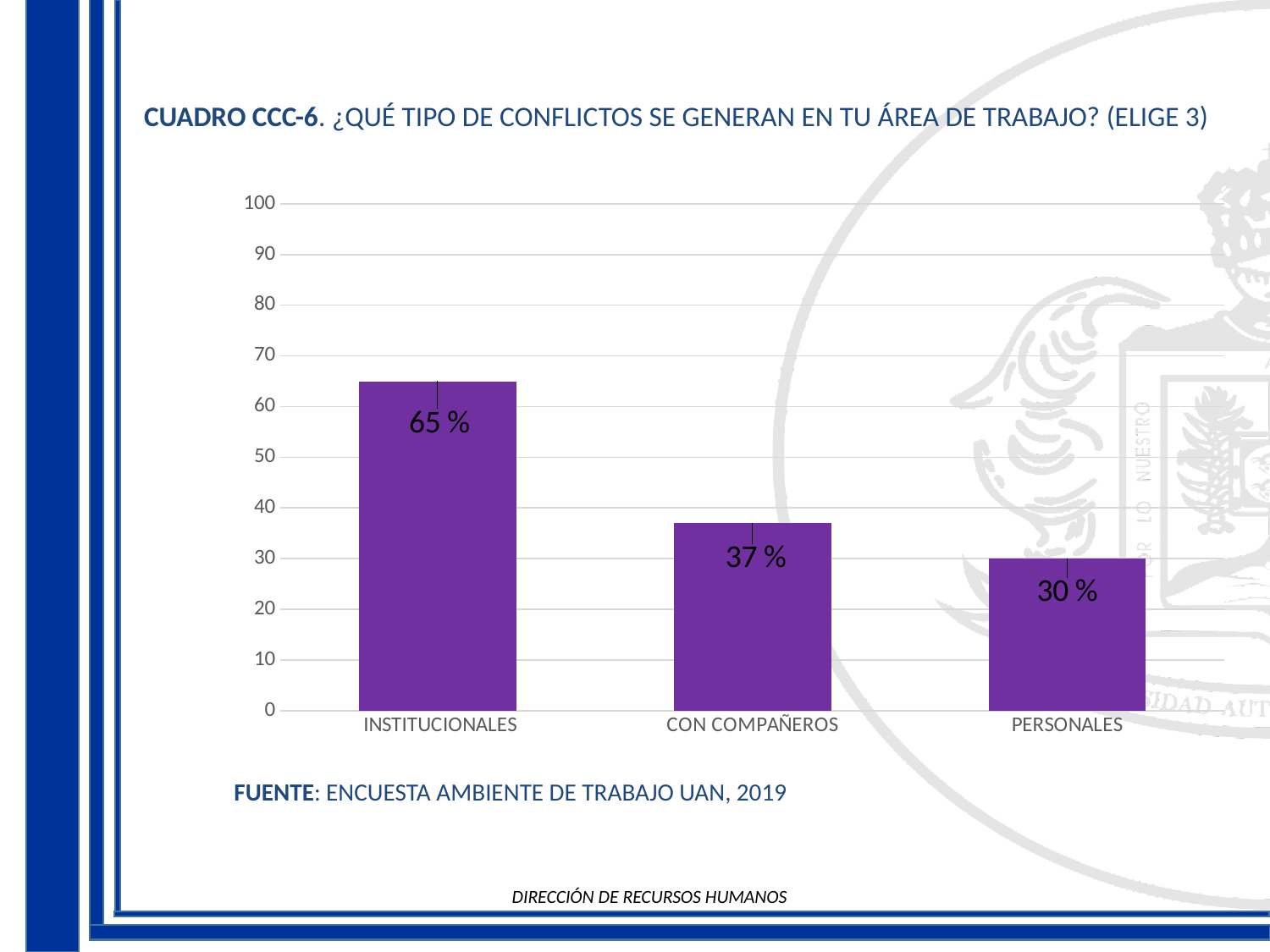
Which category has the highest value? INSTITUCIONALES What kind of chart is shown on the slide? bar chart Which is larger, the value for CON COMPAÑEROS or the value for PERSONALES? CON COMPAÑEROS What is the value for INSTITUCIONALES? 65 % What is the value for CON COMPAÑEROS? 37 % How many categories are shown on the x axis? 3 What is the value for PERSONALES? 30 % What is the difference between the values for CON COMPAÑEROS and PERSONALES? 7 % What is the difference between the values for INSTITUCIONALES and CON COMPAÑEROS? 28 % Do the values rise or fall from left to right along the x axis? fall Is the value for INSTITUCIONALES greater or less than 60? greater Which category has the lowest value? PERSONALES